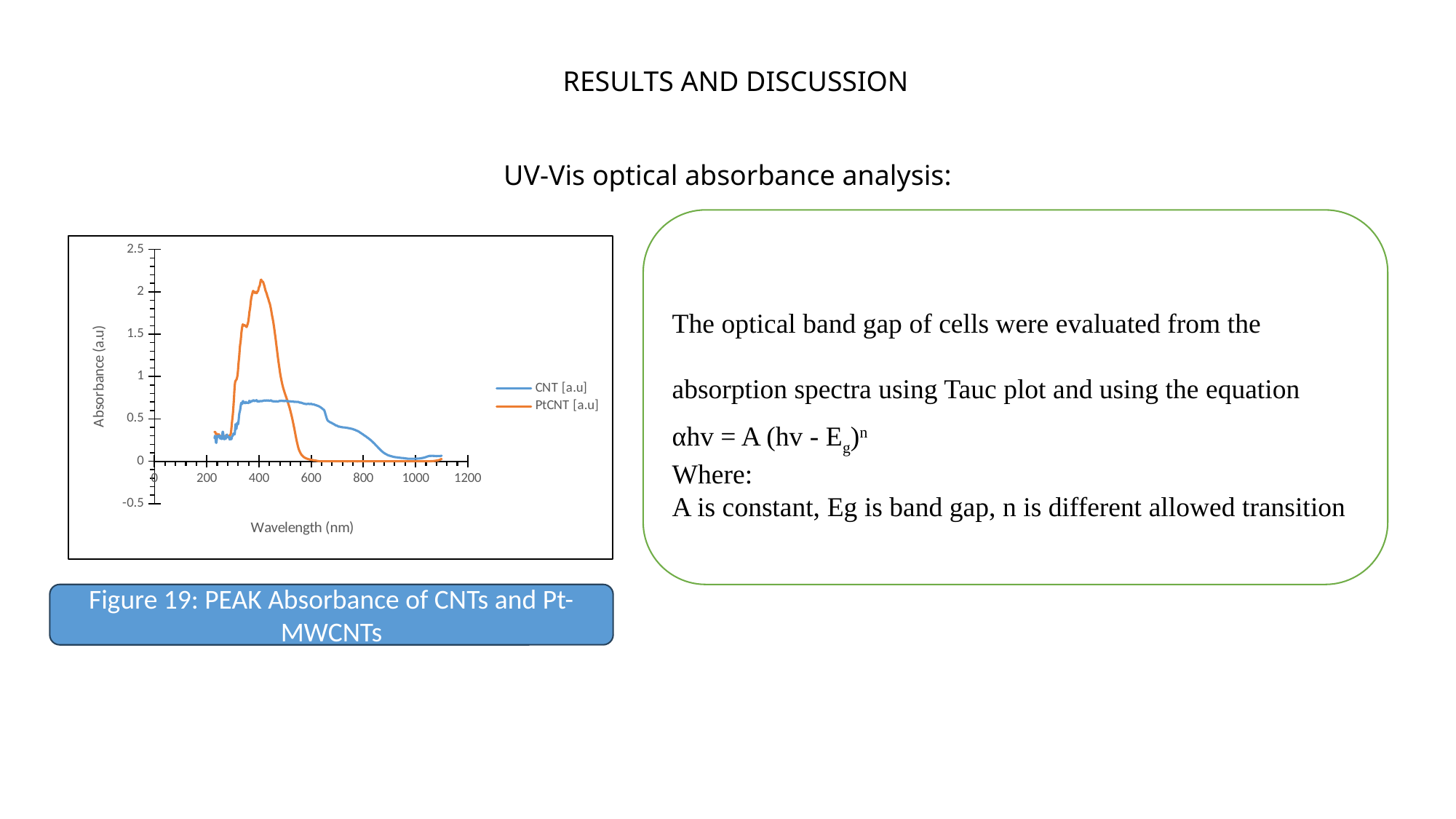
What are the two series named in the chart legend? CNT [a.u] and PtCNT [a.u] What kind of chart is shown in Figure 19? line chart How many series does the legend of the chart list? 2 Does the absorbance of the CNT [a.u] series rise or fall between 600 nm and 1000 nm? fall Is the absorbance of the PtCNT [a.u] series at 800 nm greater or less than 0.5? less Is the peak absorbance of the PtCNT [a.u] series greater or less than 2? greater Does the absorbance of the PtCNT [a.u] series rise or fall between 400 nm and 600 nm? fall At 800 nm, which series has the higher absorbance, CNT [a.u] or PtCNT [a.u]? CNT [a.u] Which series reaches the higher peak absorbance, CNT [a.u] or PtCNT [a.u]? PtCNT [a.u] Is the peak absorbance of the CNT [a.u] series greater or less than 1? less What is the title of the x axis of the chart? Wavelength (nm)